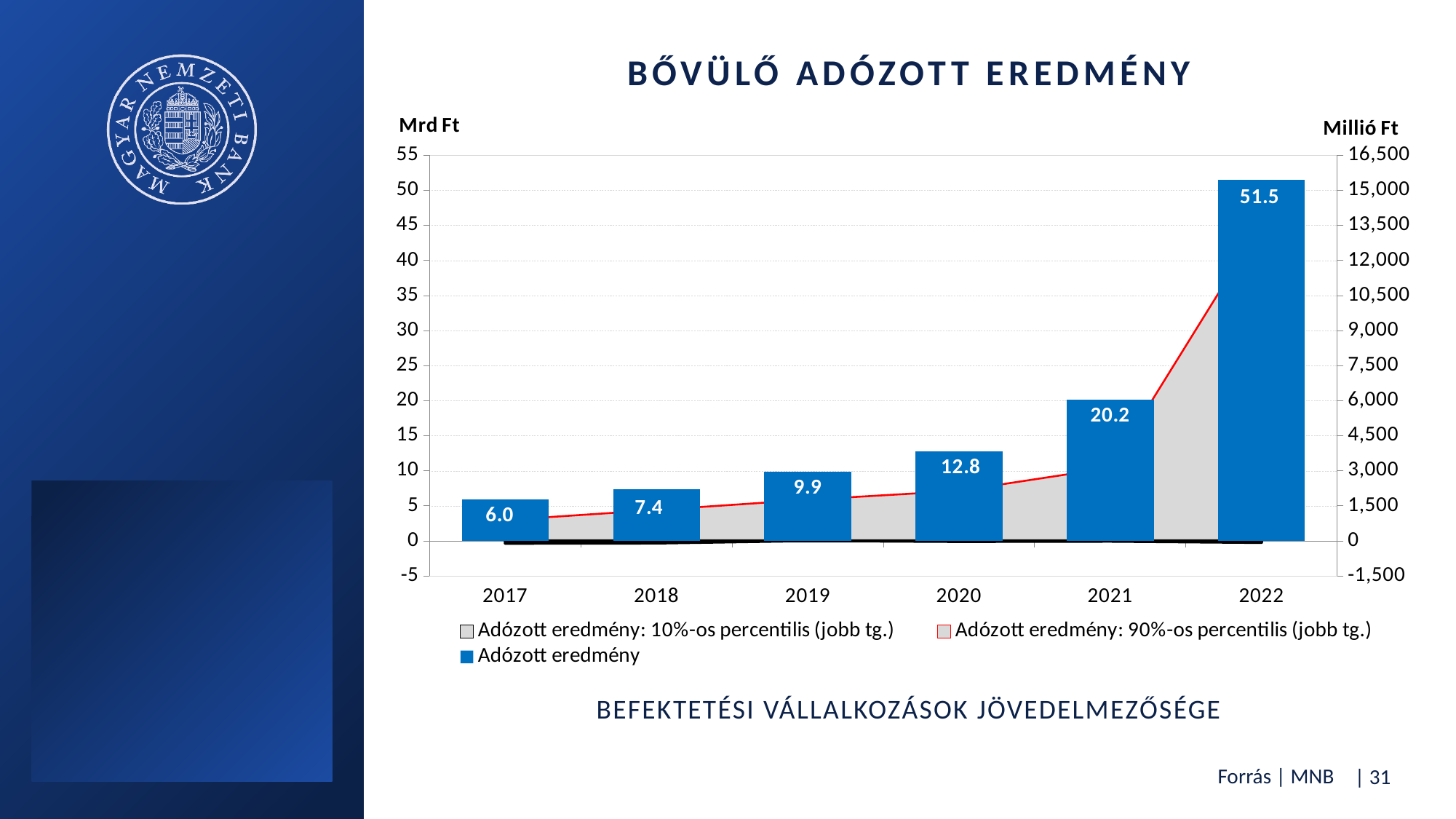
How many series does the legend list? 3 Which year has the highest Adózott eredmény? 2022 Which is larger, the Adózott eredmény for 2021 or for 2020? 2021 Does the Adózott eredmény rise or fall from 2017 to 2022? rise Which year has the lowest Adózott eredmény? 2017 What is the difference between the Adózott eredmény values for 2019 and 2018? 2.5 How many years are shown on the x axis? 6 What is the difference between the Adózott eredmény values for 2022 and 2021? 31.3 Is the Adózott eredmény value for 2021 greater or less than 15? greater What is the value of Adózott eredmény for 2017? 6.0 What is the value of Adózott eredmény for 2022? 51.5 What is the value of Adózott eredmény for 2020? 12.8